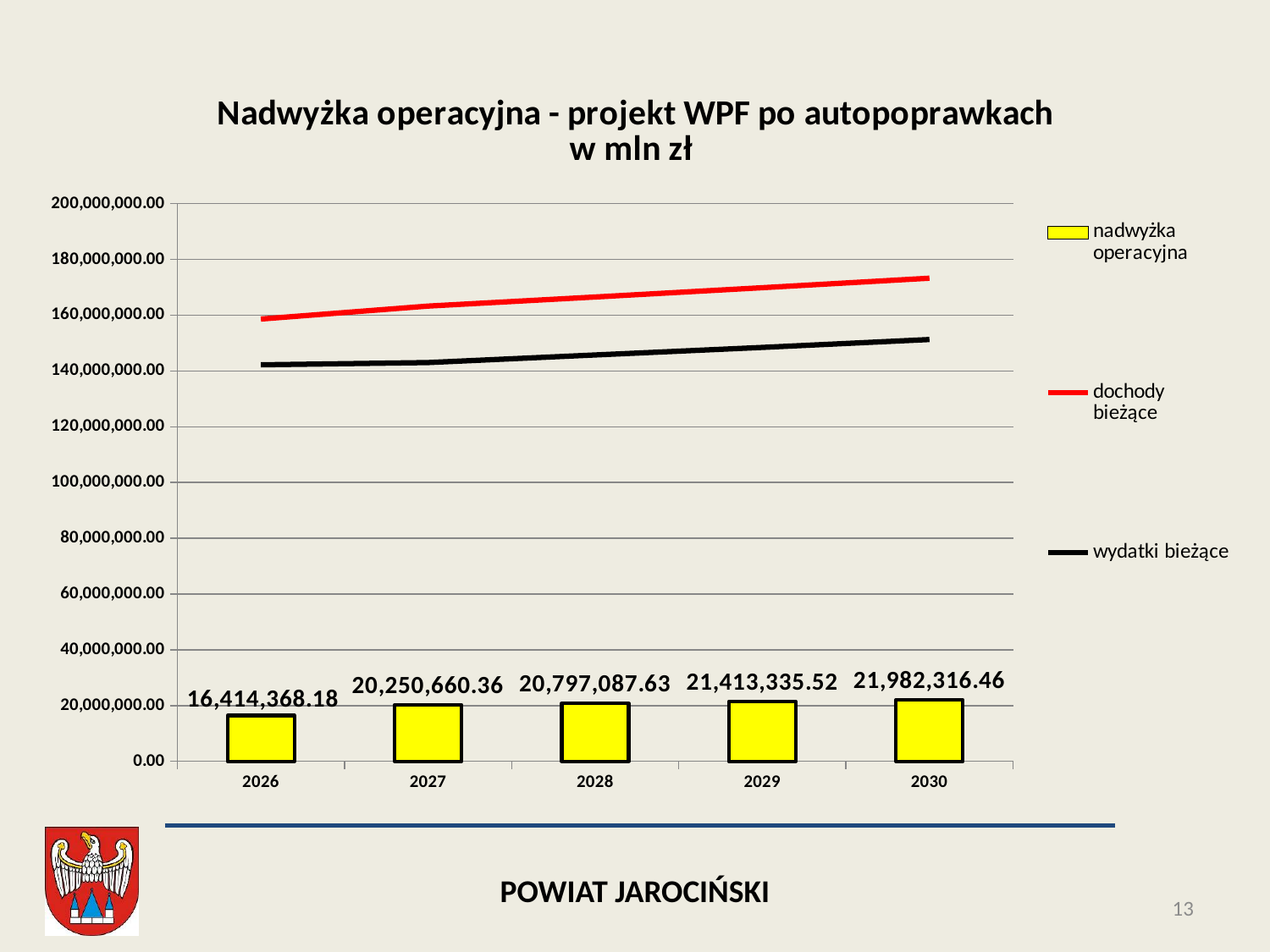
Is the value of wydatki bieżące in 2030 greater or less than 160,000,000.00? less What is the difference between the nadwyżka operacyjna in 2027 and in 2026? 3,836,292.18 In 2030, which is larger: dochody bieżące or wydatki bieżące? dochody bieżące Which year has the highest nadwyżka operacyjna? 2030 What is the value of nadwyżka operacyjna for 2028? 20,797,087.63 Which year has the lowest nadwyżka operacyjna? 2026 What is the value of nadwyżka operacyjna for 2026? 16,414,368.18 What is the value of nadwyżka operacyjna for 2030? 21,982,316.46 What is the difference between the nadwyżka operacyjna in 2030 and in 2026? 5,567,948.28 How many series does the legend list? 3 Is the value of dochody bieżące in 2030 greater or less than 160,000,000.00? greater How many years are shown on the x axis? 5